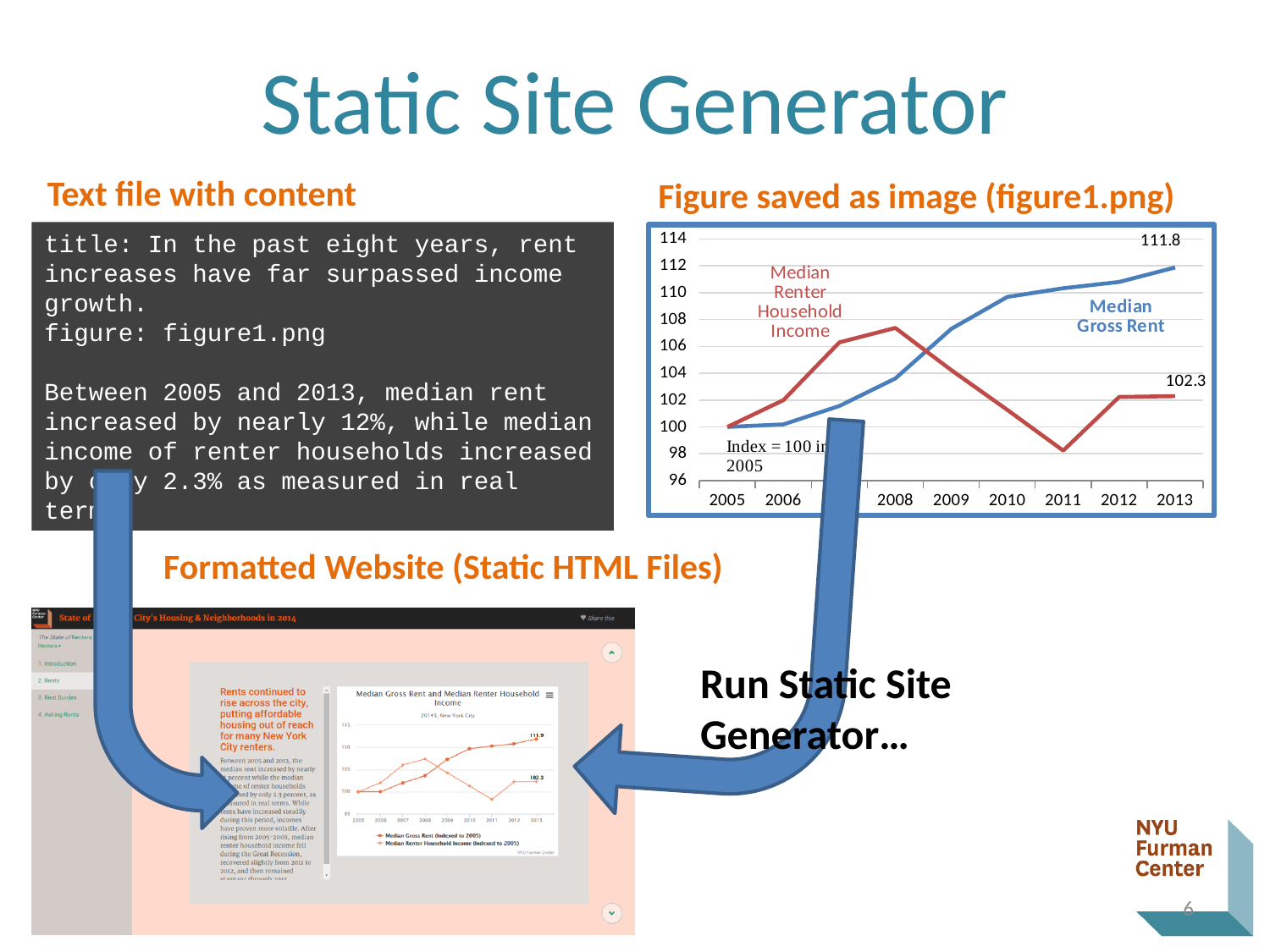
In the figure1.png chart, is the value for Median Gross Rent in 2010 greater or less than 108? greater In the figure1.png chart, what is the value of Median Renter Household Income in 2013? 102.3 In the figure1.png chart, in which year is Median Renter Household Income at its lowest? 2011 What kind of chart is the figure saved as figure1.png in the top right of the slide? line chart In the figure1.png chart, which series is drawn in blue? Median Gross Rent In the figure1.png chart, is the value for Median Renter Household Income in 2011 greater or less than 100? less In the figure1.png chart, what is the value of Median Gross Rent in 2013? 111.8 How many data series are plotted in the figure1.png chart? 2 In the figure1.png chart, does Median Gross Rent rise or fall from 2005 to 2013? rise In the figure1.png chart, in which year is Median Renter Household Income at its highest? 2008 In the figure1.png chart, what is the difference between Median Gross Rent and Median Renter Household Income in 2013? 9.5 In the figure1.png chart, which series is higher in 2013, Median Gross Rent or Median Renter Household Income? Median Gross Rent